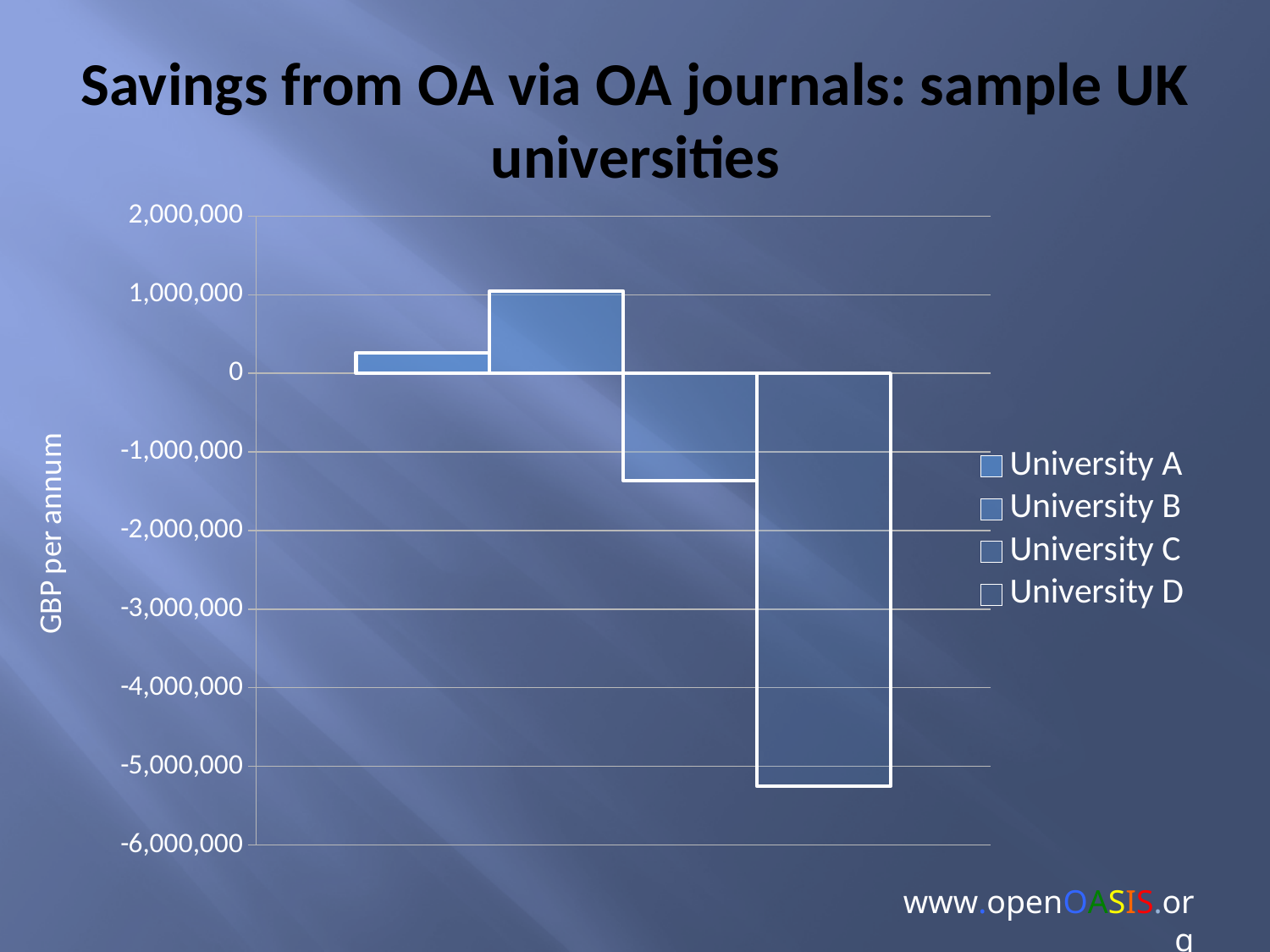
How many bars are plotted in the chart? 4 Is the value for University C greater or less than -1,000,000? less How many series does the legend list? 4 What is the title of the chart's vertical axis? GBP per annum Which university has the highest value in the chart? University B Is the value for University D greater or less than -5,000,000? less Which university has the lowest value in the chart? University D What type of chart is shown on the slide? bar chart Which is larger, the value for University C or University D? University C What is the title of the chart? Savings from OA via OA journals: sample UK universities Is the value for University A greater or less than 0? greater Which is larger, the value for University A or University B? University B